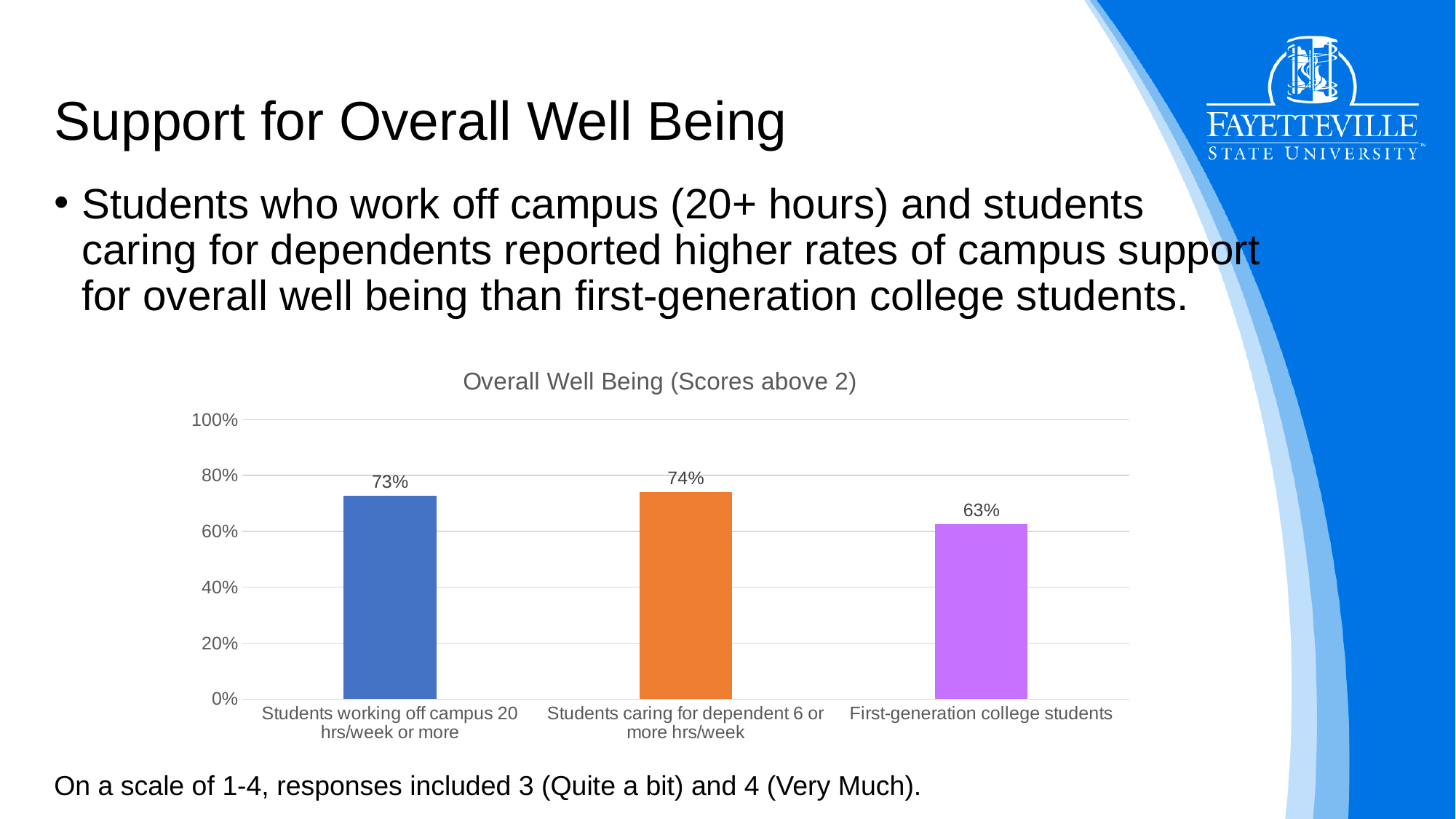
What kind of chart is shown on the slide? bar chart How many categories are shown in the chart? 3 What is the difference between the values for Students working off campus 20 hrs/week or more and First-generation college students? 10% Which is larger: the value for Students working off campus 20 hrs/week or more or the value for First-generation college students? Students working off campus 20 hrs/week or more What is the value for Students working off campus 20 hrs/week or more? 73% What is the difference between the values for Students caring for dependent 6 or more hrs/week and First-generation college students? 11% What is the value for Students caring for dependent 6 or more hrs/week? 74% Which category has the lowest value? First-generation college students Which category has the highest value? Students caring for dependent 6 or more hrs/week What is the title of the chart? Overall Well Being (Scores above 2) Is the value for First-generation college students greater or less than 80%? less What is the value for First-generation college students? 63%